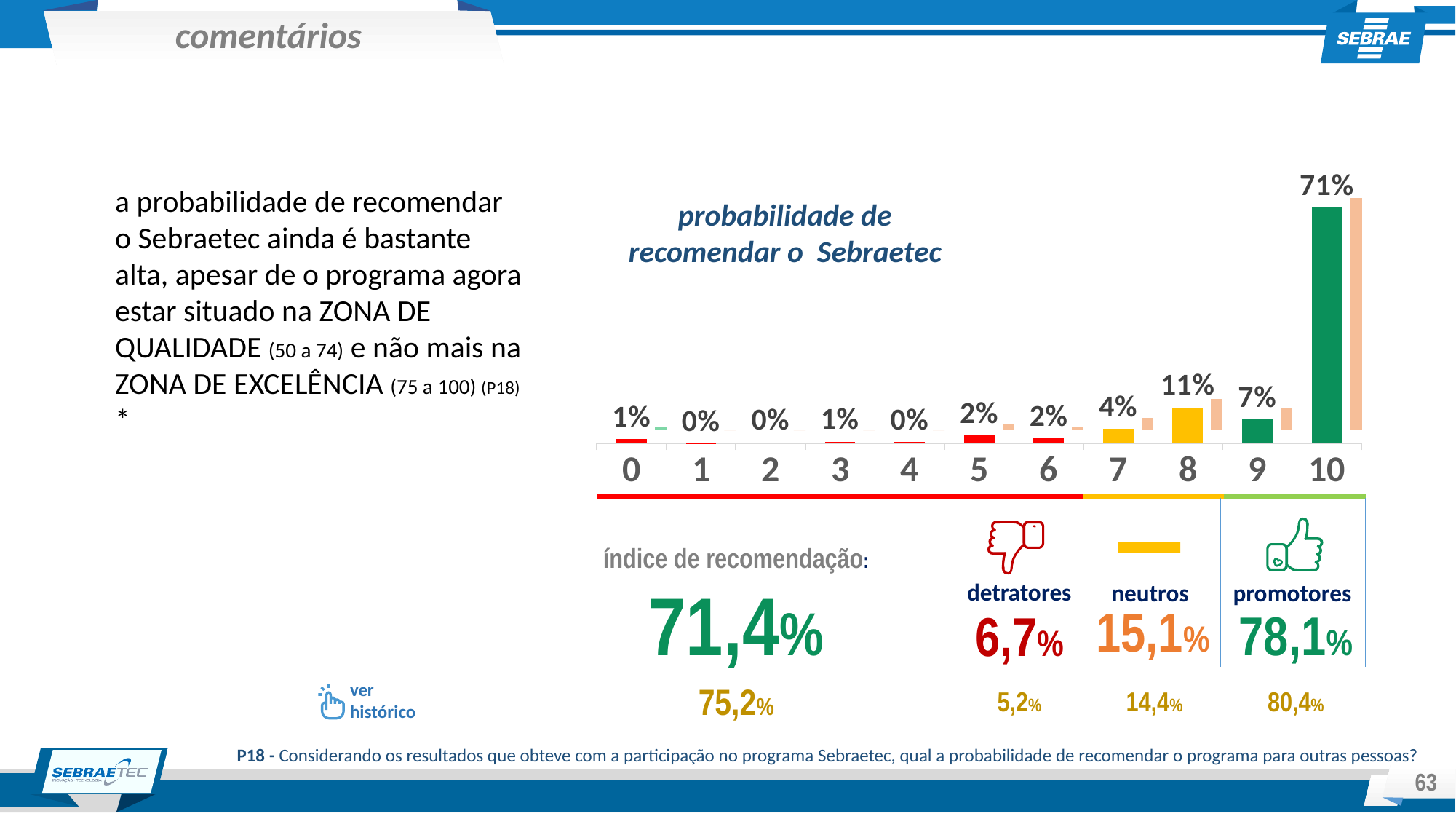
In the chart 'probabilidade de recomendar o Sebraetec', what is the value for category 5? 2% In the chart 'probabilidade de recomendar o Sebraetec', which category has the highest value? 10 What kind of chart is 'probabilidade de recomendar o Sebraetec'? bar chart How many categories are shown on the x axis of the chart 'probabilidade de recomendar o Sebraetec'? 11 In the chart 'probabilidade de recomendar o Sebraetec', what is the value for category 8? 11% In the chart 'probabilidade de recomendar o Sebraetec', what is the value for category 7? 4% In the chart 'probabilidade de recomendar o Sebraetec', what is the value for category 9? 7% What is the title of the chart on the slide? probabilidade de recomendar o Sebraetec In the chart 'probabilidade de recomendar o Sebraetec', what is the difference between the values for categories 8 and 9? 4% In the chart 'probabilidade de recomendar o Sebraetec', which category has the larger value, 8 or 9? 8 In the chart 'probabilidade de recomendar o Sebraetec', what is the value for category 10? 71% In the chart 'probabilidade de recomendar o Sebraetec', what is the difference between the values for categories 10 and 8? 60%